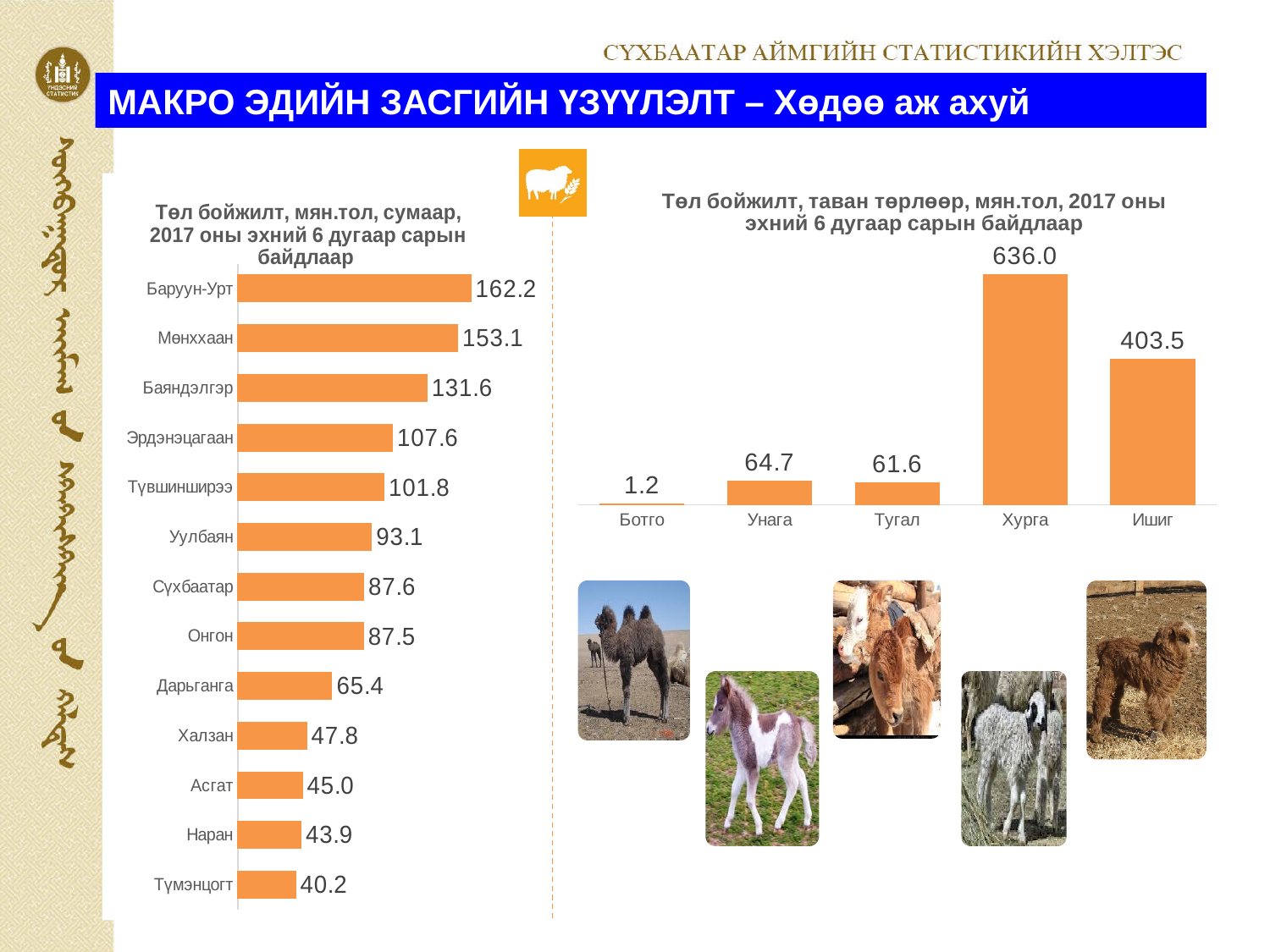
In the right chart (by five types), what is the difference between the values for Хурга and Ишиг? 232.5 What type of chart is the left chart (by soum)? Bar chart In the left chart (by soum), how many soums are shown? 13 In the left chart (by soum), which soum has the highest value? Баруун-Урт In the left chart (by soum), which is larger, the value for Дарьганга or the value for Халзан? Дарьганга In the left chart (by soum), what is the value for Баяндэлгэр? 131.6 In the left chart (by soum), what is the difference between the values for Баруун-Урт and Мөнххаан? 9.1 In the right chart (by five types), which category has the lowest value? Ботго In the right chart (by five types), what is the value for Ишиг? 403.5 In the left chart (by soum), which soum has the lowest value? Түмэнцогт In the right chart (by five types), how many categories are shown? 5 In the right chart (by five types), which category has the highest value? Хурга